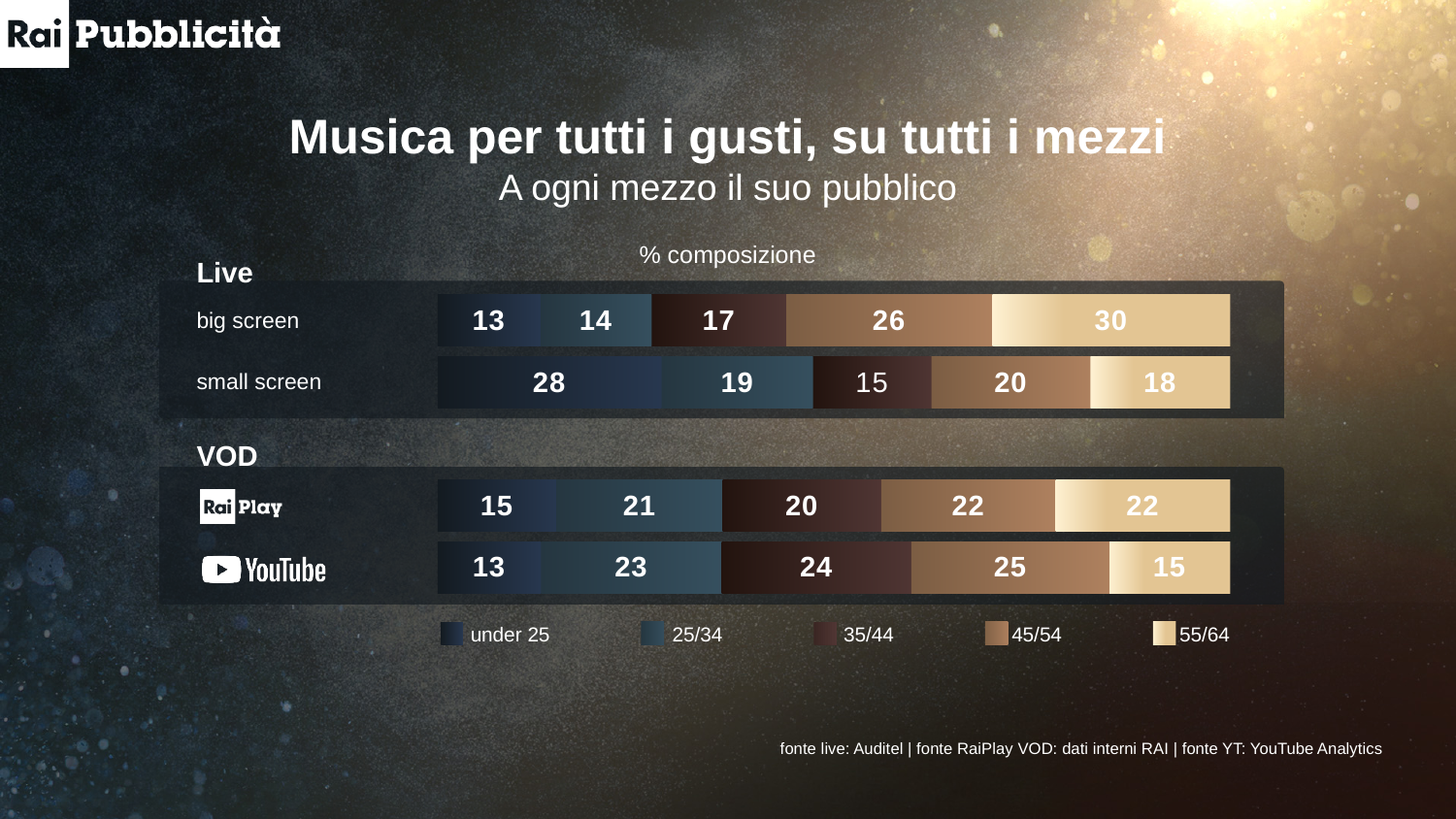
What is the value for the 35/44 segment of the YouTube bar? 24 What is the value for the 55/64 segment of the big screen bar? 30 Which age group has the smallest segment in the small screen bar? 35/44 How many bars (rows) are shown in the chart? 4 What is the difference between the under 25 values for small screen and big screen? 15 What kind of chart is shown on the slide? Stacked bar chart Which age group has the largest segment in the big screen bar? 55/64 Which is larger: the 45/54 value for YouTube or the 45/54 value for RaiPlay? YouTube What is the value for the 25/34 segment of the RaiPlay bar? 21 What is the total of the YouTube stacked bar? 100 What is the value for the under 25 segment of the small screen bar? 28 How many series does the legend list? 5